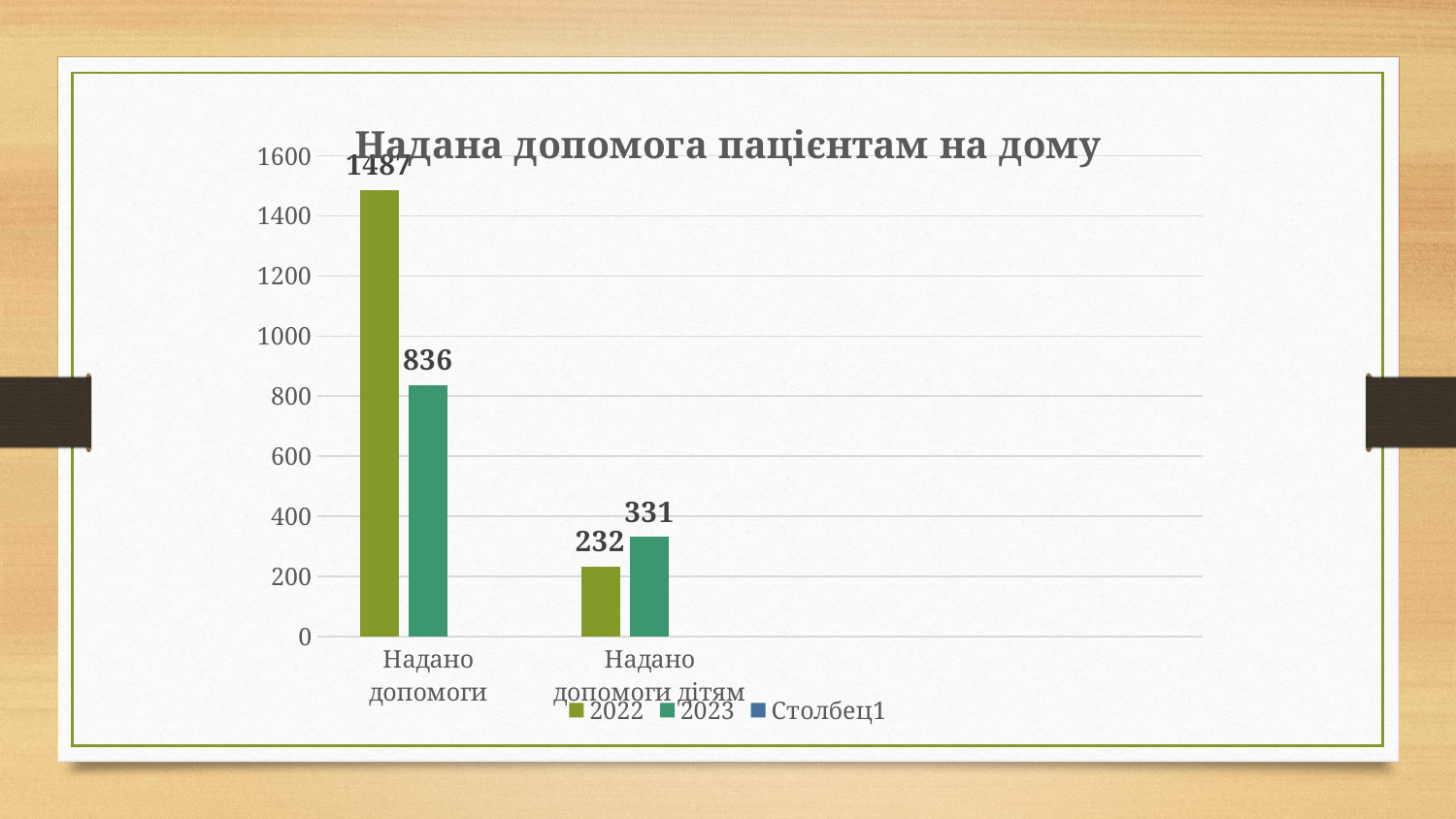
What is the title of the chart? Надана допомога пацієнтам на дому How many categories are shown on the x axis? 2 What is the value for 2023 in the "Надано допомоги дітям" category? 331 How many series does the legend list? 3 What is the value for 2023 in the "Надано допомоги" category? 836 What is the difference between the 2023 and 2022 values for "Надано допомоги дітям"? 99 What is the difference between the 2022 and 2023 values for "Надано допомоги"? 651 Which bar has the lowest value on the chart? 2022, Надано допомоги дітям Which bar has the highest value on the chart? 2022, Надано допомоги For "Надано допомоги дітям", which year has the larger value, 2022 or 2023? 2023 What is the value for 2022 in the "Надано допомоги дітям" category? 232 What is the value for 2022 in the "Надано допомоги" category? 1487